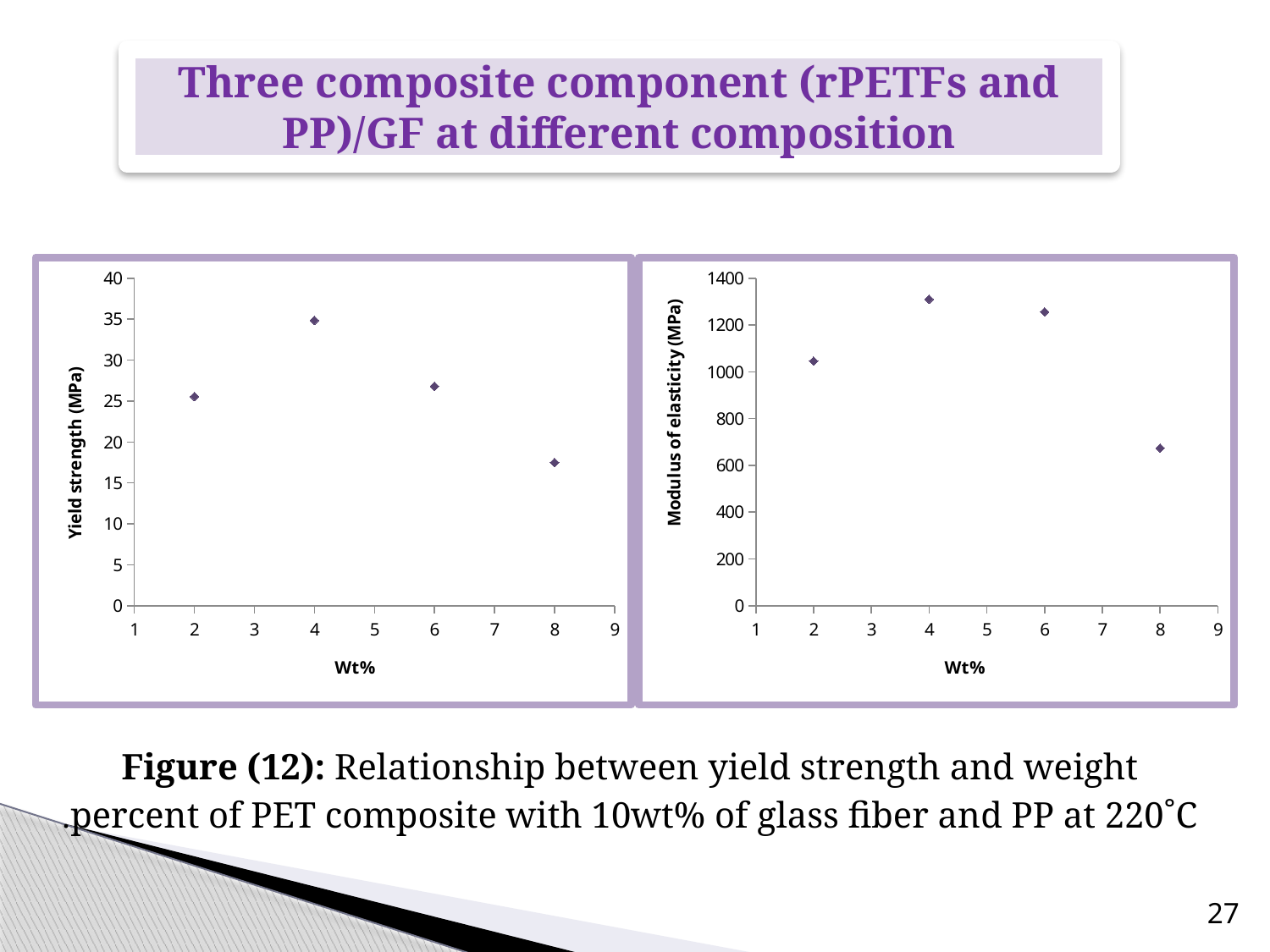
How many data points are plotted on the right chart (Modulus of elasticity vs Wt%)? 4 On the left chart (Yield strength vs Wt%), at which Wt% is the yield strength highest? 4 On the left chart (Yield strength vs Wt%), is the yield strength at 8 Wt% greater or less than 20? less What kind of chart is the left chart (Yield strength vs Wt%)? scatter chart On the left chart (Yield strength vs Wt%), at which Wt% is the yield strength lowest? 8 On the left chart (Yield strength vs Wt%), which has the larger yield strength, 4 Wt% or 8 Wt%? 4 Wt% What is the y-axis label of the right chart? Modulus of elasticity (MPa) On the right chart (Modulus of elasticity vs Wt%), at which Wt% is the modulus of elasticity lowest? 8 On the left chart (Yield strength vs Wt%), is the yield strength at 4 Wt% greater or less than 30? greater How many data points are plotted on the left chart (Yield strength vs Wt%)? 4 On the left chart (Yield strength vs Wt%), do the values rise or fall from 4 Wt% to 8 Wt%? fall On the right chart (Modulus of elasticity vs Wt%), is the modulus of elasticity at 8 Wt% greater or less than 800? less